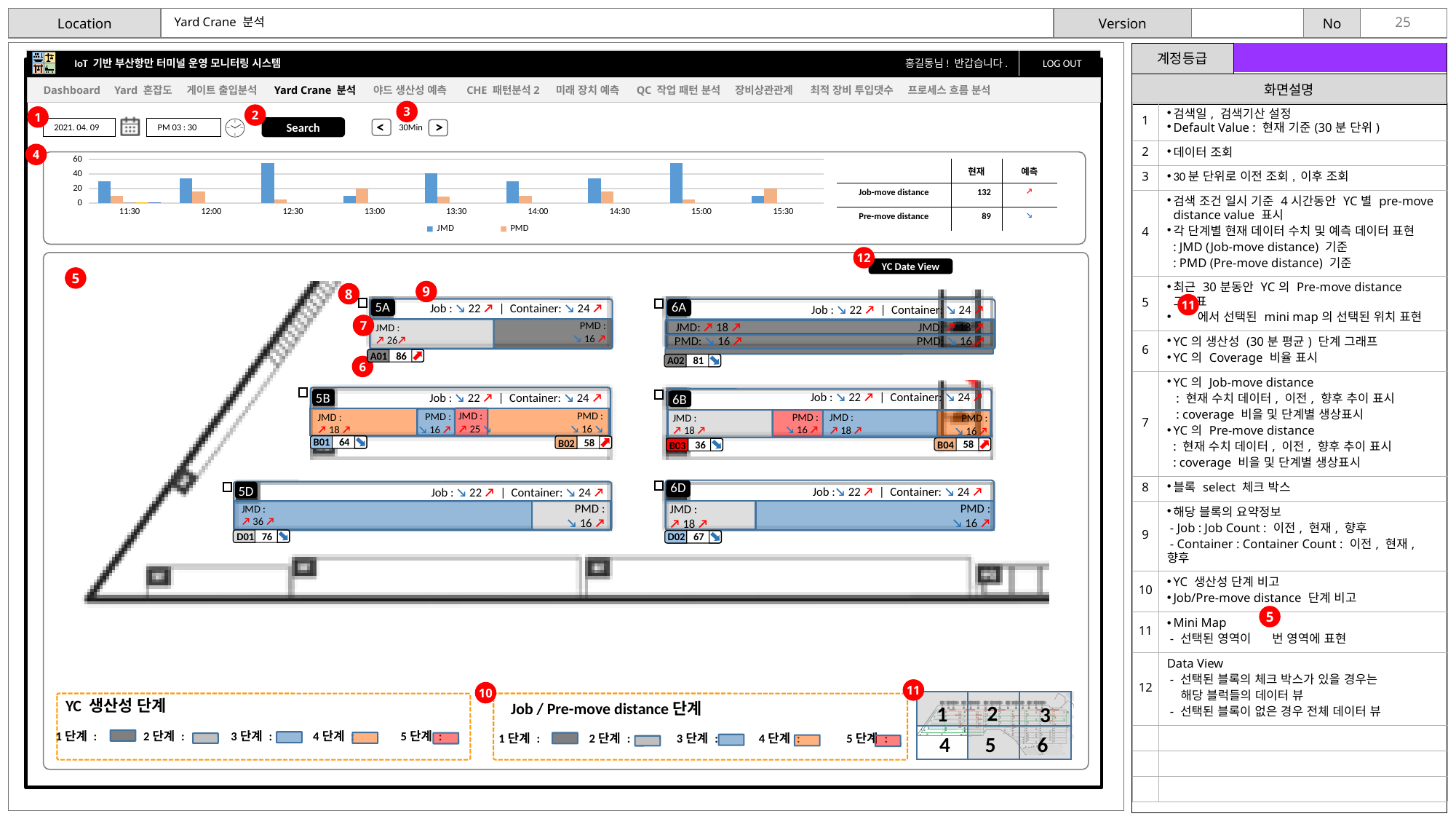
In the top bar chart, is the PMD value at 11:30 greater or less than 20? less What kind of chart is shown at the top of the slide? bar chart In the top bar chart, is the JMD value at 15:00 greater or less than 40? greater What are the two series named in the legend of the top bar chart? JMD and PMD How many time points are shown on the x axis of the top bar chart? 9 In the top bar chart, which series has the larger value at 13:00, JMD or PMD? PMD In the top bar chart, is the JMD value at 13:00 greater or less than 20? less In the top bar chart, which series has the larger value at 11:30, JMD or PMD? JMD How many series does the legend of the top bar chart list? 2 In the top bar chart, which series has the larger value at 15:30, JMD or PMD? PMD